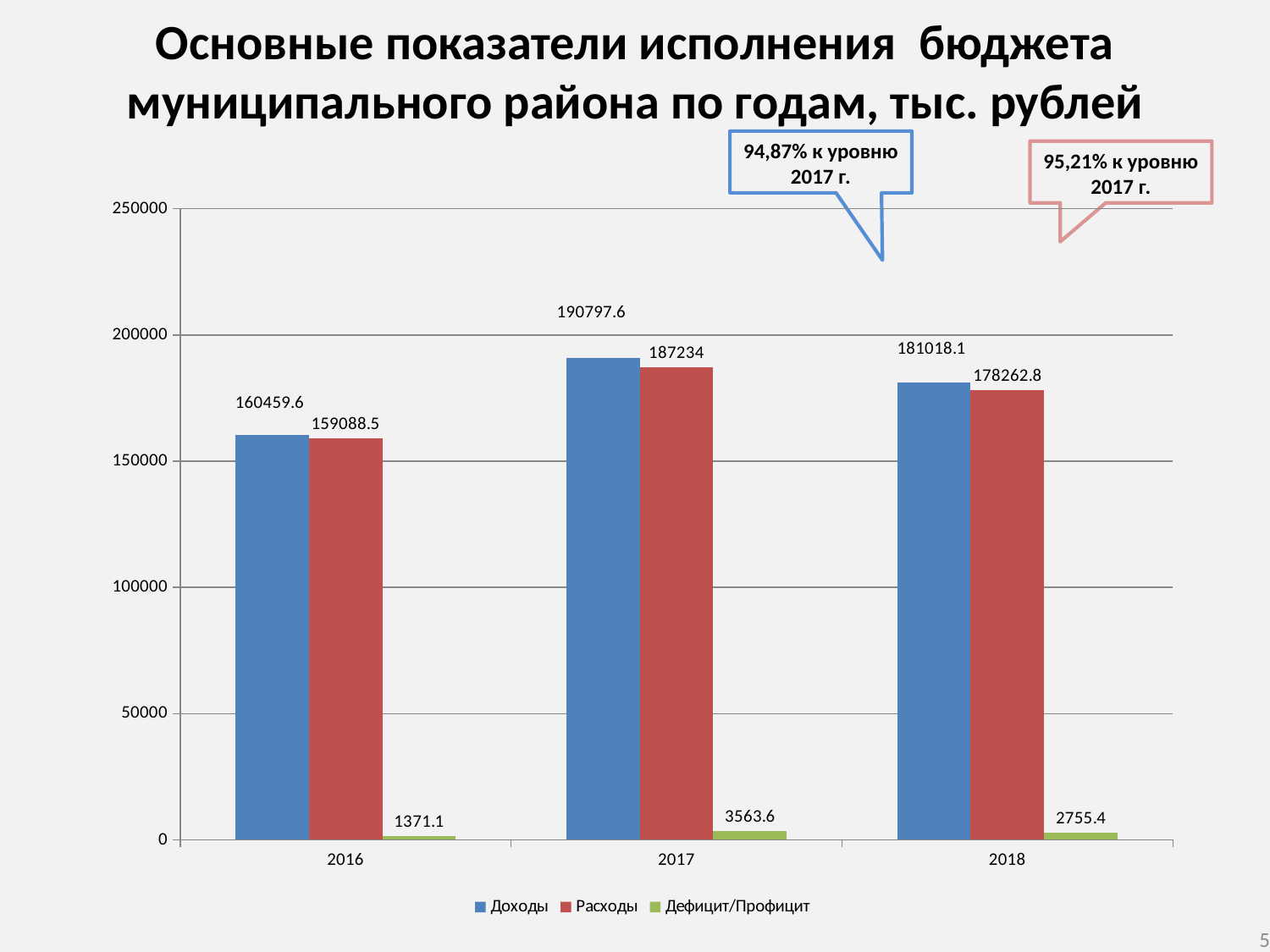
Which is larger in 2018: Доходы or Расходы? Доходы What is the value of Доходы for 2017? 190797.6 What is the value of Дефицит/Профицит for 2018? 2755.4 How many series does the legend list? 3 What is the difference between Доходы in 2017 and Доходы in 2016? 30338 What kind of chart is shown on the slide? Bar chart In which year is Доходы highest? 2017 What is the value of Расходы for 2016? 159088.5 What is the value of Расходы for 2018? 178262.8 Which colour represents Расходы in the chart? Red What is the difference between Доходы and Расходы in 2017? 3563.6 In which year is Дефицит/Профицит lowest? 2016